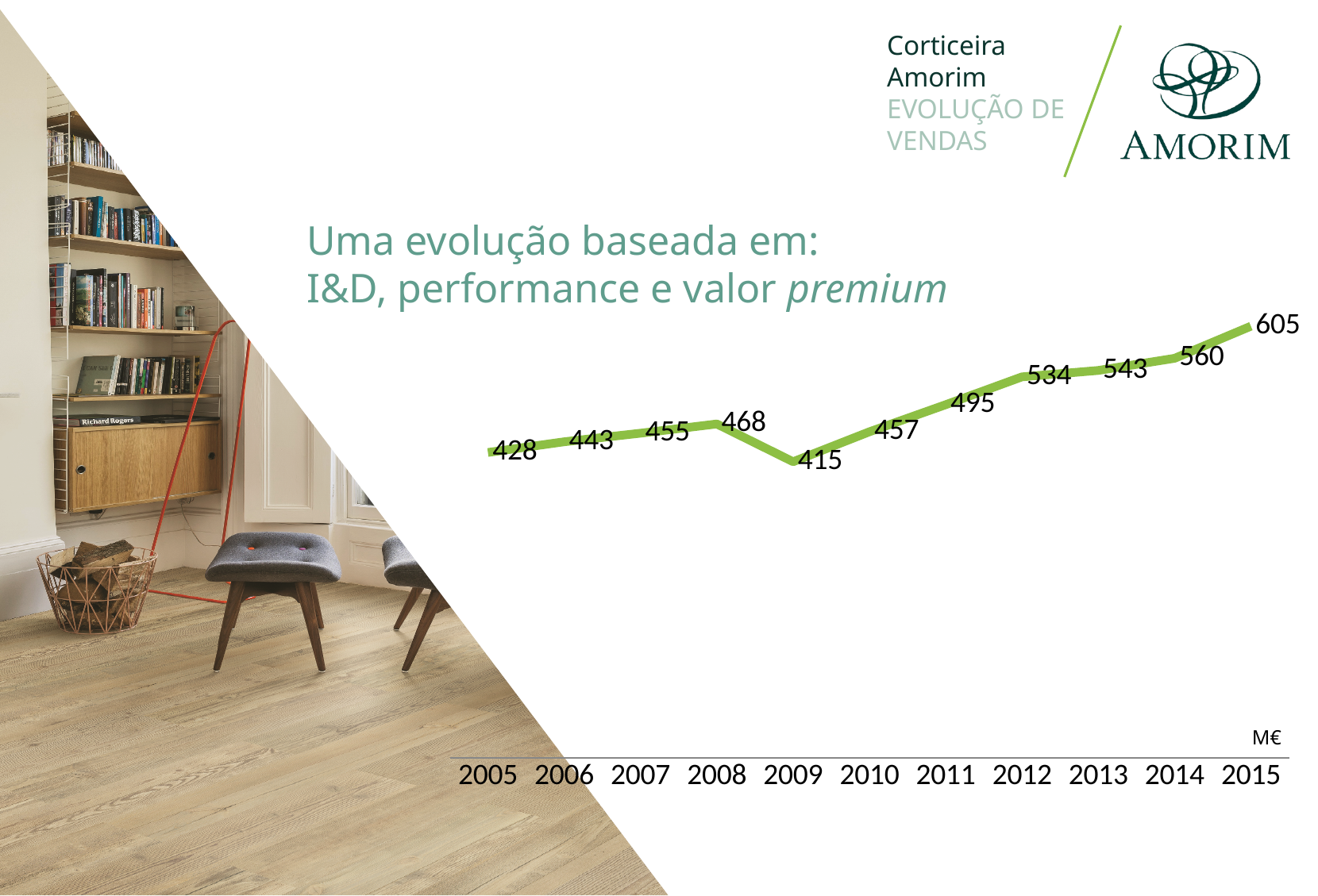
Which year has a larger sales value, 2008 or 2010? 2008 What is the sales value for 2015? 605 What is the sales value for 2005? 428 Do the sales values rise or fall from 2009 to 2015? rise What is the difference between the sales values for 2008 and 2009? 53 What kind of chart is shown on the slide? line chart What is the difference between the sales values for 2015 and 2005? 177 Which year has the lowest sales value? 2009 What unit is indicated for the values on the chart? M€ How many years are shown on the x axis? 11 What is the sales value for 2009? 415 Which year has the highest sales value? 2015